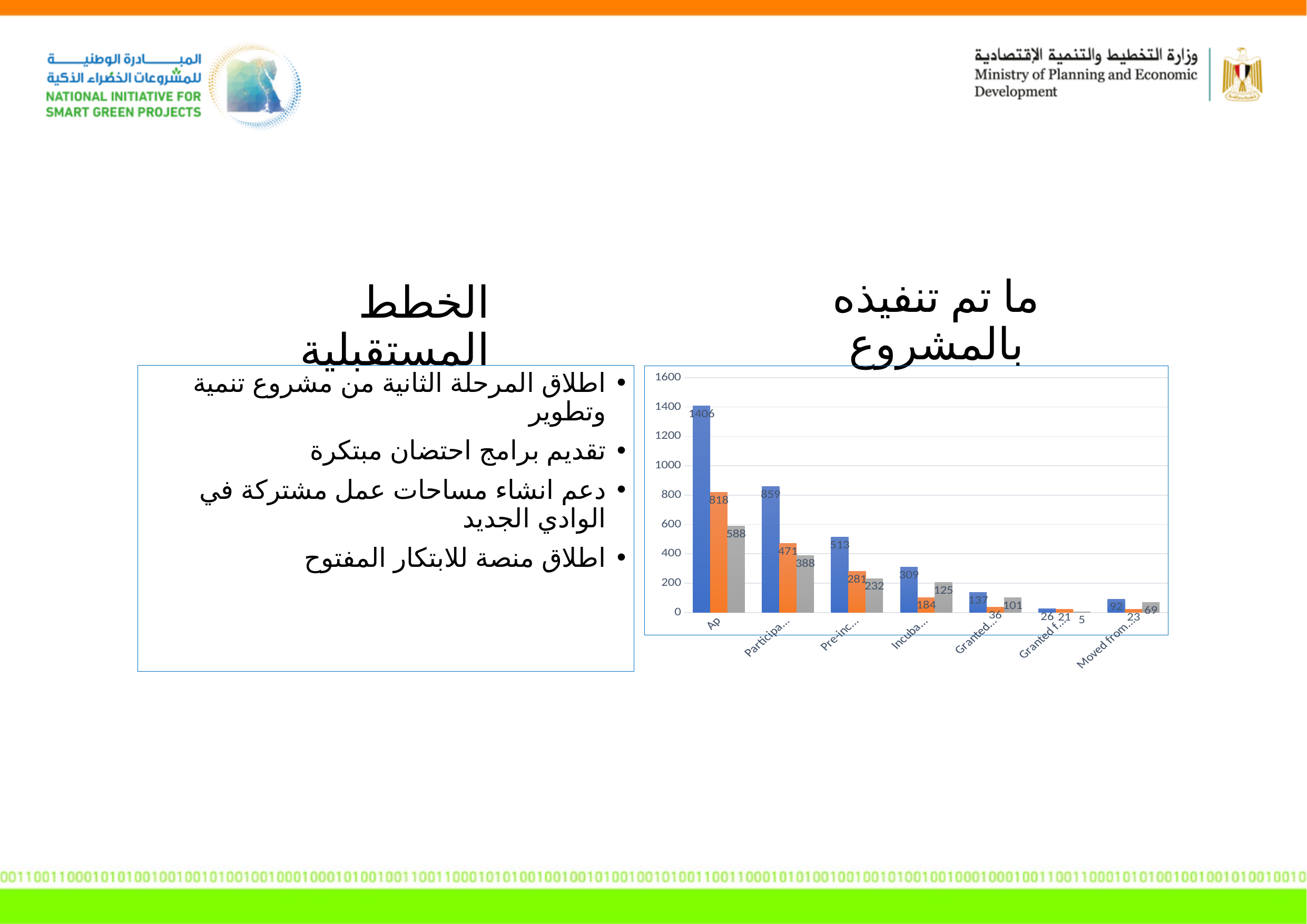
What kind of chart is shown on the slide? bar chart What is the maximum value shown on the chart's vertical axis? 1600 How many bars are there in each category group of the chart? 3 What is the value of the blue bar for the first category ("Ap")? 1406 What is the difference between the blue bar (1406) and the orange bar (818) in the first category group? 588 What is the value of the gray bar for the first category ("Ap")? 588 In the second category group, which bar is larger: the orange bar (471) or the gray bar (388)? orange (471) What is the lowest value labelled on the chart? 5 Is the blue bar of the first category group greater or less than 1200? greater How many category groups are plotted along the x axis of the chart? 7 What is the value of the orange bar for the first category ("Ap")? 818 What is the highest value labelled on the chart? 1406